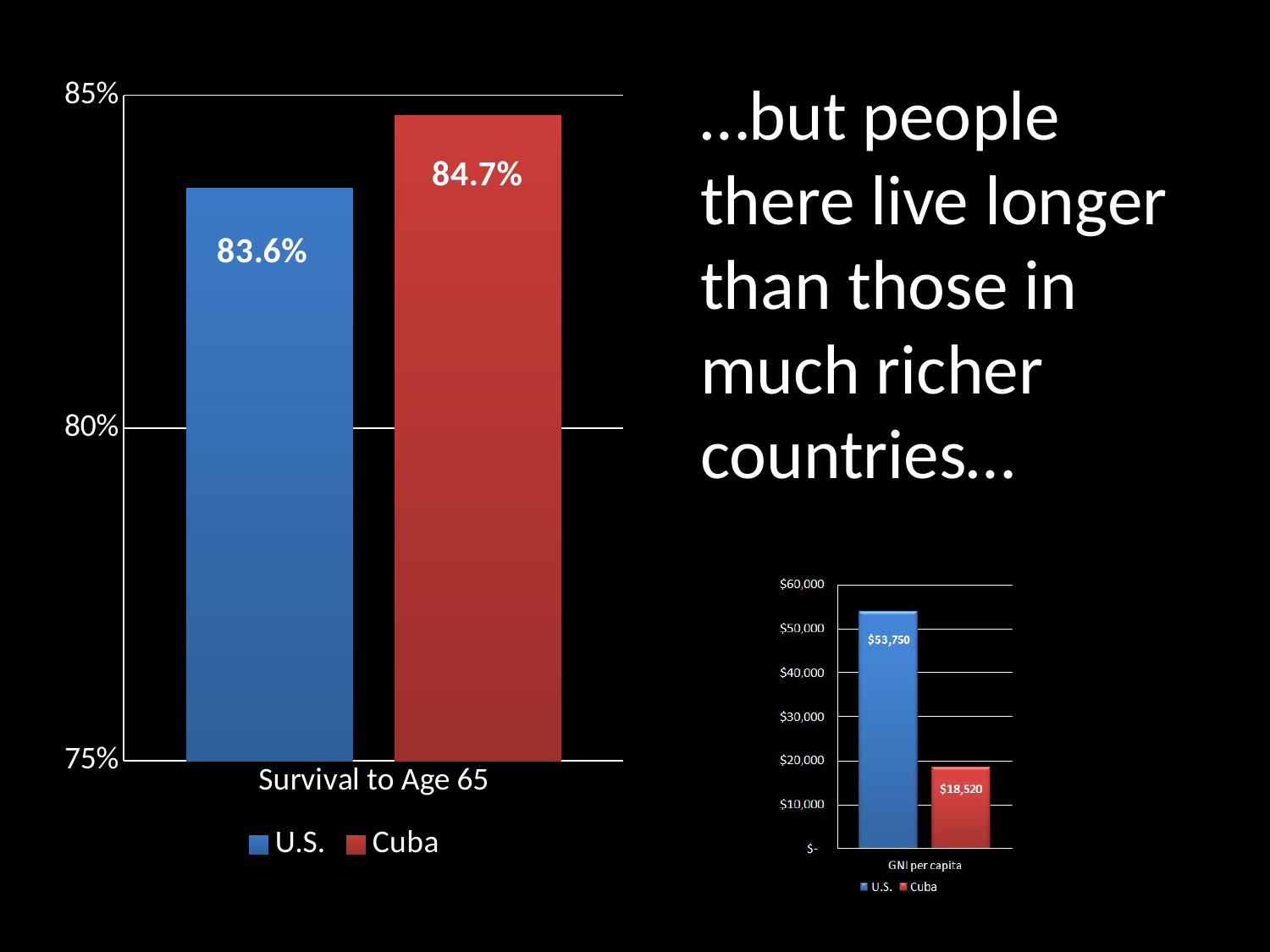
In the GNI per capita chart, is the value for Cuba greater or less than $20,000? less In the Survival to Age 65 chart, what is the value for the U.S.? 83.6% In the Survival to Age 65 chart, what is the value for Cuba? 84.7% In the Survival to Age 65 chart, what is the difference between Cuba's and the U.S.'s values? 1.1 percentage points In the GNI per capita chart, which series has the lower value? Cuba In the GNI per capita chart, what is the value for Cuba? $18,520 In the Survival to Age 65 chart, which series has the higher value? Cuba In the Survival to Age 65 chart, how many series does the legend list? 2 In the GNI per capita chart, what is the difference between the U.S. and Cuba values? $35,230 What kind of chart is the Survival to Age 65 chart? Bar chart In the Survival to Age 65 chart, is the value for the U.S. greater or less than 80%? greater In the GNI per capita chart, what is the value for the U.S.? $53,750